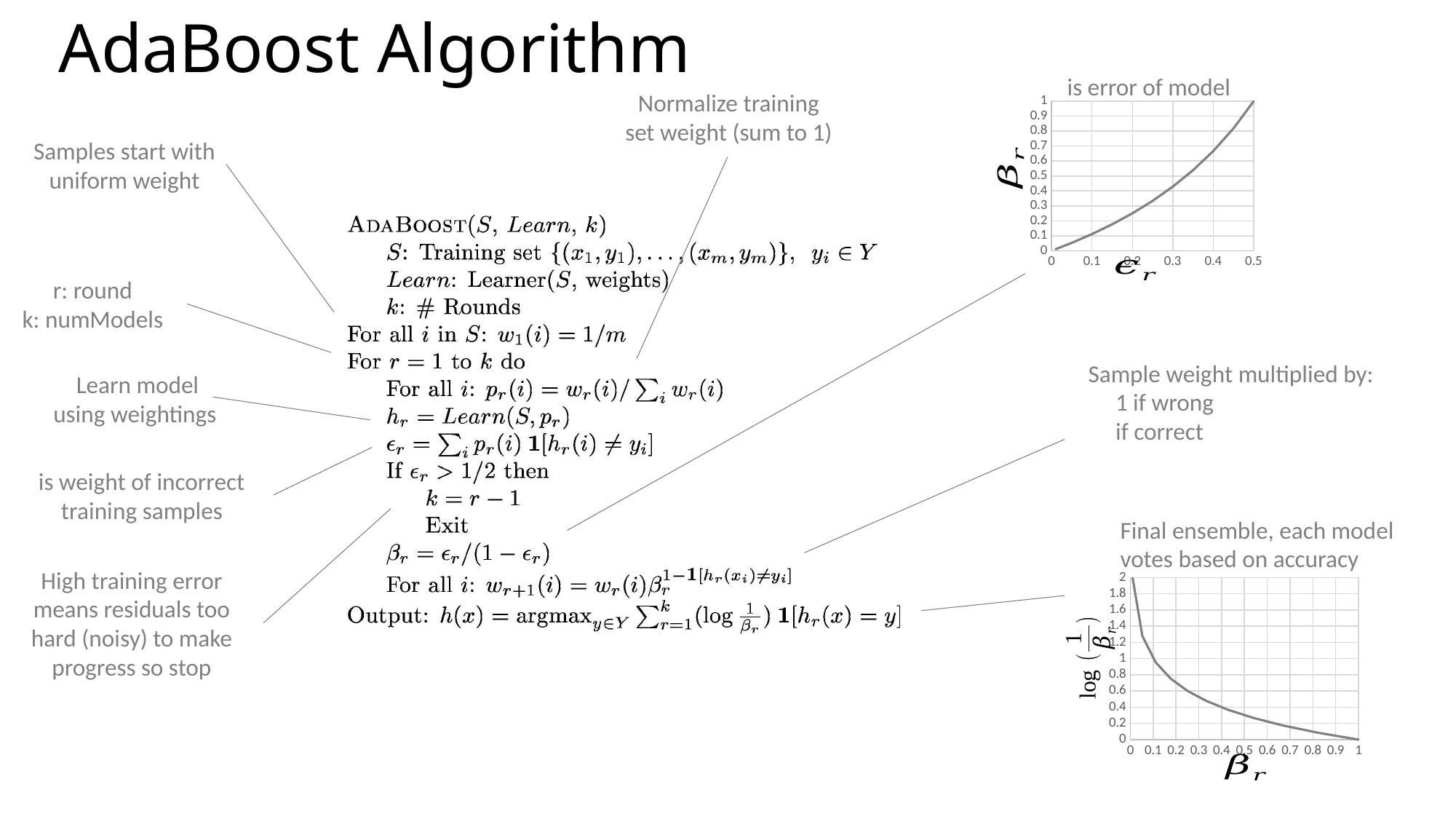
In the top-right chart, is the value of β_r at ε_r = 0.2 greater or less than 0.3? less What kind of chart is the bottom-right chart plotting log(1/β_r) against β_r? line chart In the top-right chart, does β_r rise or fall as ε_r increases along the x axis? rise In the bottom-right chart, what is the value of log(1/β_r) when β_r is 1? 0 What is the highest value shown on the y axis of the bottom-right chart? 2 In the bottom-right chart, is the value of log(1/β_r) at β_r = 0.1 greater or less than 0.8? greater In the top-right chart, what is the value of β_r when ε_r is 0.5? 1 What kind of chart is the top-right chart plotting β_r against ε_r? line chart In the top-right chart, is the value of β_r at ε_r = 0.4 greater or less than 0.6? greater In the bottom-right chart, does log(1/β_r) rise or fall as β_r increases along the x axis? fall